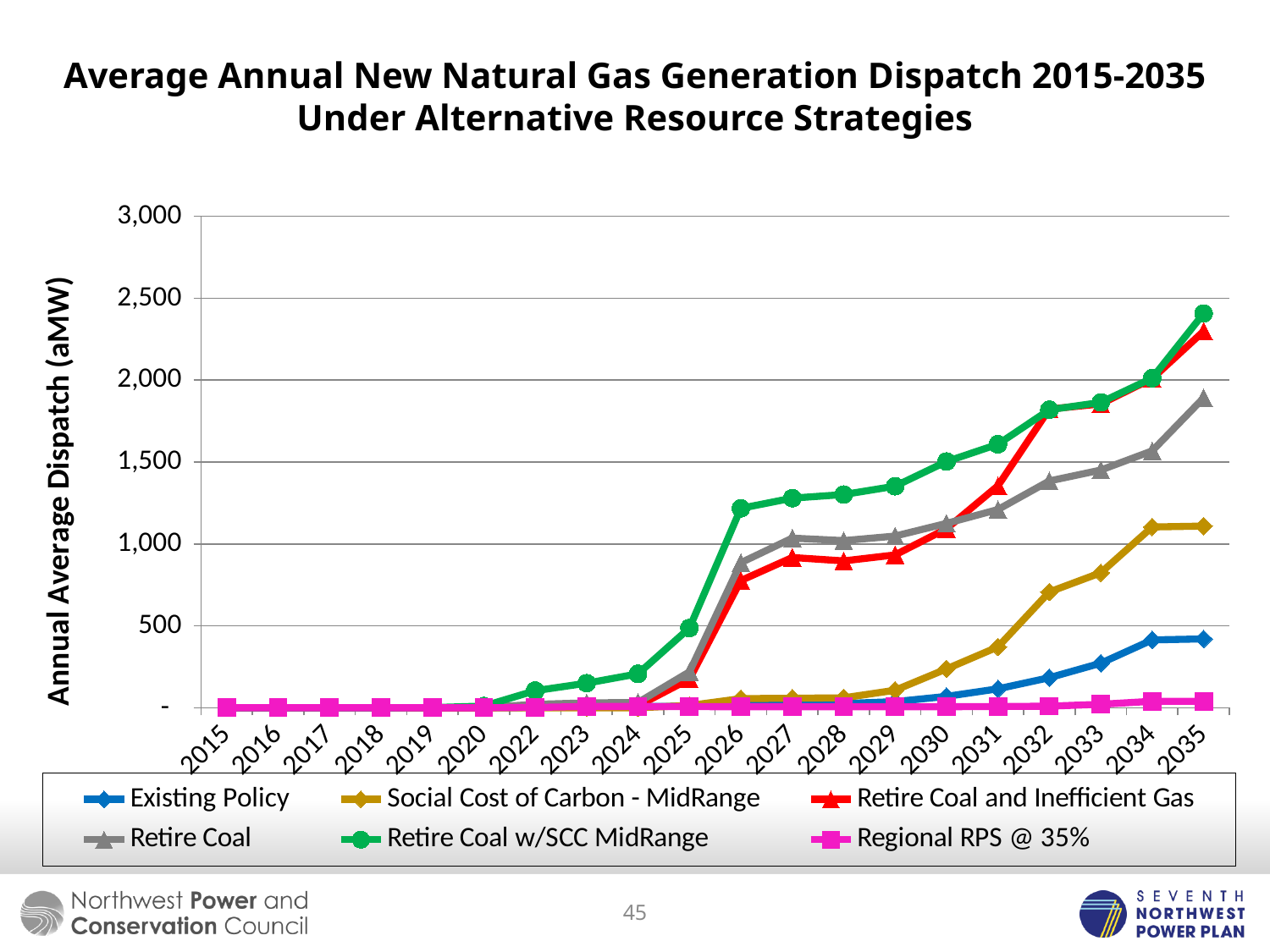
Is the value for Existing Policy in 2035 greater or less than 500? less What is the title of the vertical axis? Annual Average Dispatch (aMW) Does the Retire Coal w/SCC MidRange series generally rise or fall from 2015 to 2035? rise What kind of chart is shown on the slide? line chart In 2035, which is larger: Retire Coal or Social Cost of Carbon - MidRange? Retire Coal In 2035, which is larger: Existing Policy or Regional RPS @ 35%? Existing Policy Is the value for Retire Coal w/SCC MidRange in 2035 greater or less than 2,000? greater Which series has the lowest value in 2035? Regional RPS @ 35% Is the value for Retire Coal in 2035 greater or less than 2,000? less Which series has the highest value in 2035? Retire Coal w/SCC MidRange How many series does the legend list? 6